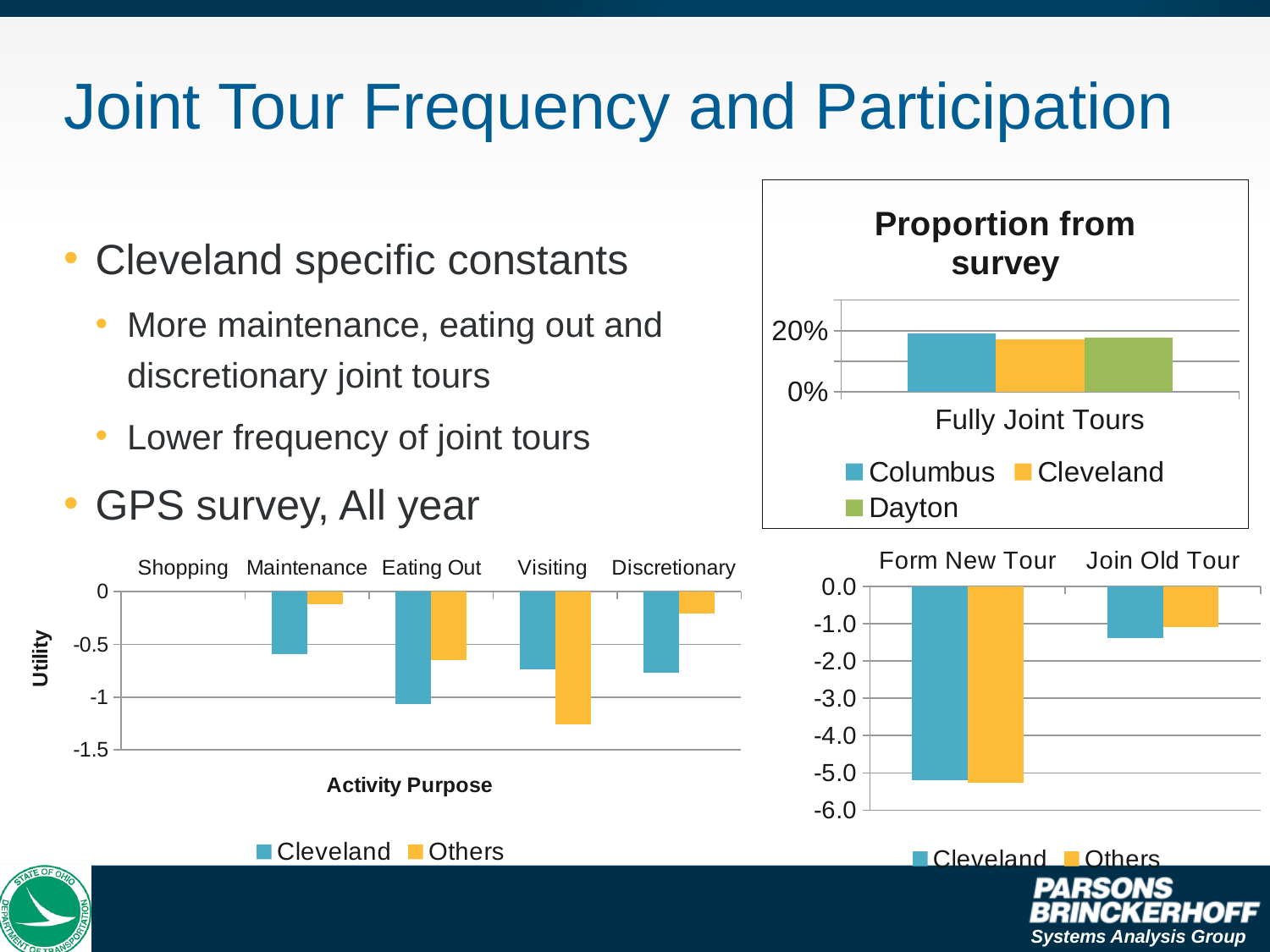
In the bottom-left "Activity Purpose" chart, how many series does the legend list? 2 In the "Proportion from survey" chart, what is the single category shown on the x axis? Fully Joint Tours In the bottom-right chart, for Cleveland, which category has the higher (less negative) value, Form New Tour or Join Old Tour? Join Old Tour What kind of chart is the "Proportion from survey" chart at the top right? bar chart In the bottom-left "Activity Purpose" chart, how many activity purpose categories are shown on the x axis? 5 In the bottom-left "Activity Purpose" chart, is the Others value for Maintenance greater or less than -0.5? greater In the bottom-left "Activity Purpose" chart, which category has the lowest Others value? Visiting In the bottom-left "Activity Purpose" chart, for Visiting, which series has the lower (more negative) value, Cleveland or Others? Others In the bottom-right chart, is the Cleveland value for Form New Tour greater or less than -5.0? less In the bottom-left "Activity Purpose" chart, is the Cleveland value for Eating Out greater or less than -1? less In the bottom-right chart, how many categories are shown on the x axis? 2 In the "Proportion from survey" chart, how many series does the legend list? 3